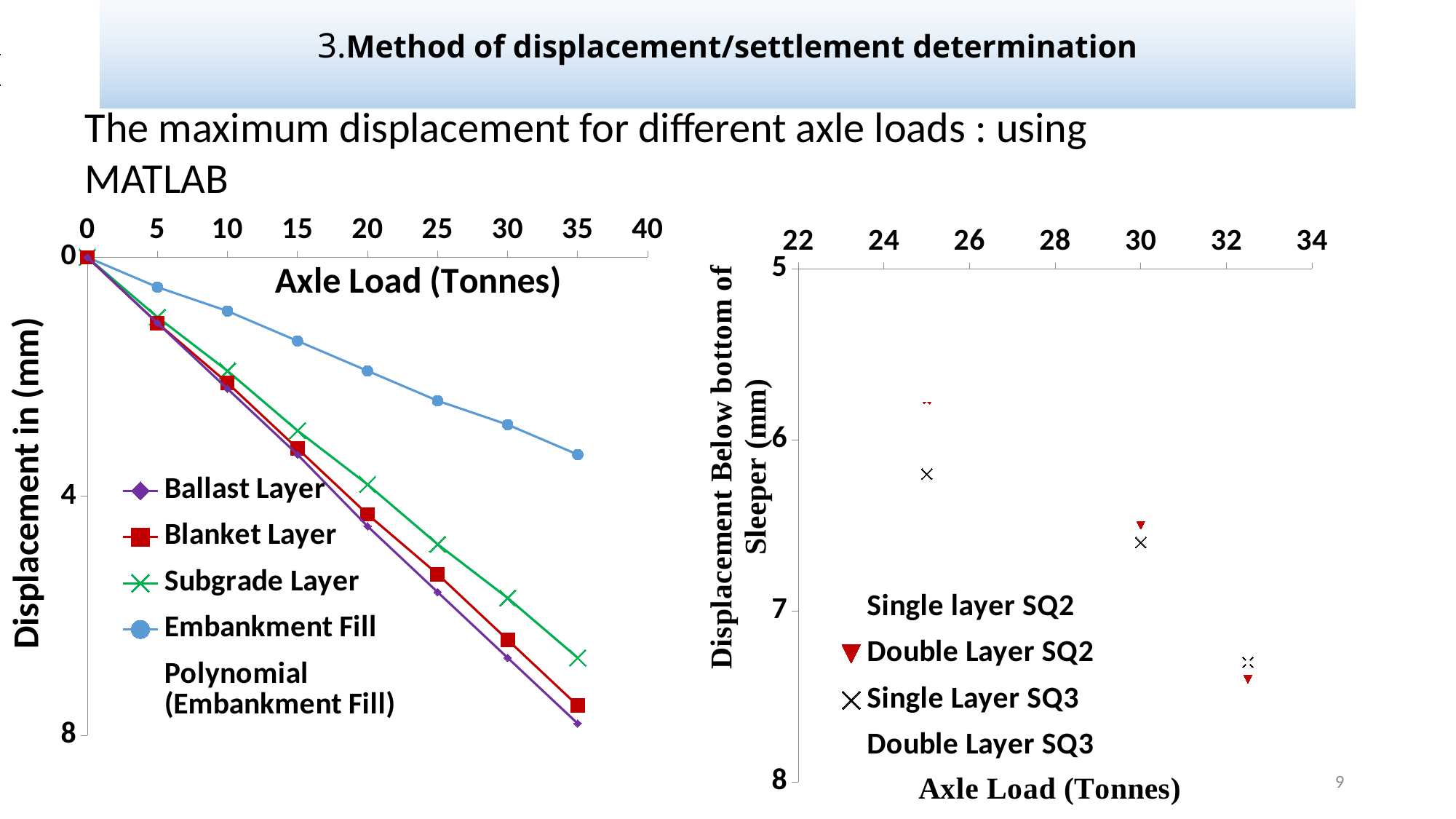
What kind of chart is the left chart showing displacement versus axle load? line chart In the left chart, is the displacement for Ballast Layer at 35 tonnes greater or less than 4 mm? greater In the left chart, at 35 tonnes, which has the larger displacement: Ballast Layer or Embankment Fill? Ballast Layer How many series does the legend of the left chart list? 5 In the left chart, which series has the smallest displacement at 35 tonnes? Embankment Fill In the left chart, does the displacement for the Ballast Layer increase or decrease as the axle load increases? increase In the left chart, is the displacement for Embankment Fill at 35 tonnes greater or less than 4 mm? less In the right chart, is the displacement for Single Layer SQ3 at 25 tonnes greater or less than 6 mm? greater How many series does the legend of the right chart list? 4 What is the x-axis title of the right chart? Axle Load (Tonnes) In the left chart, how many data points are plotted for the Embankment Fill series? 8